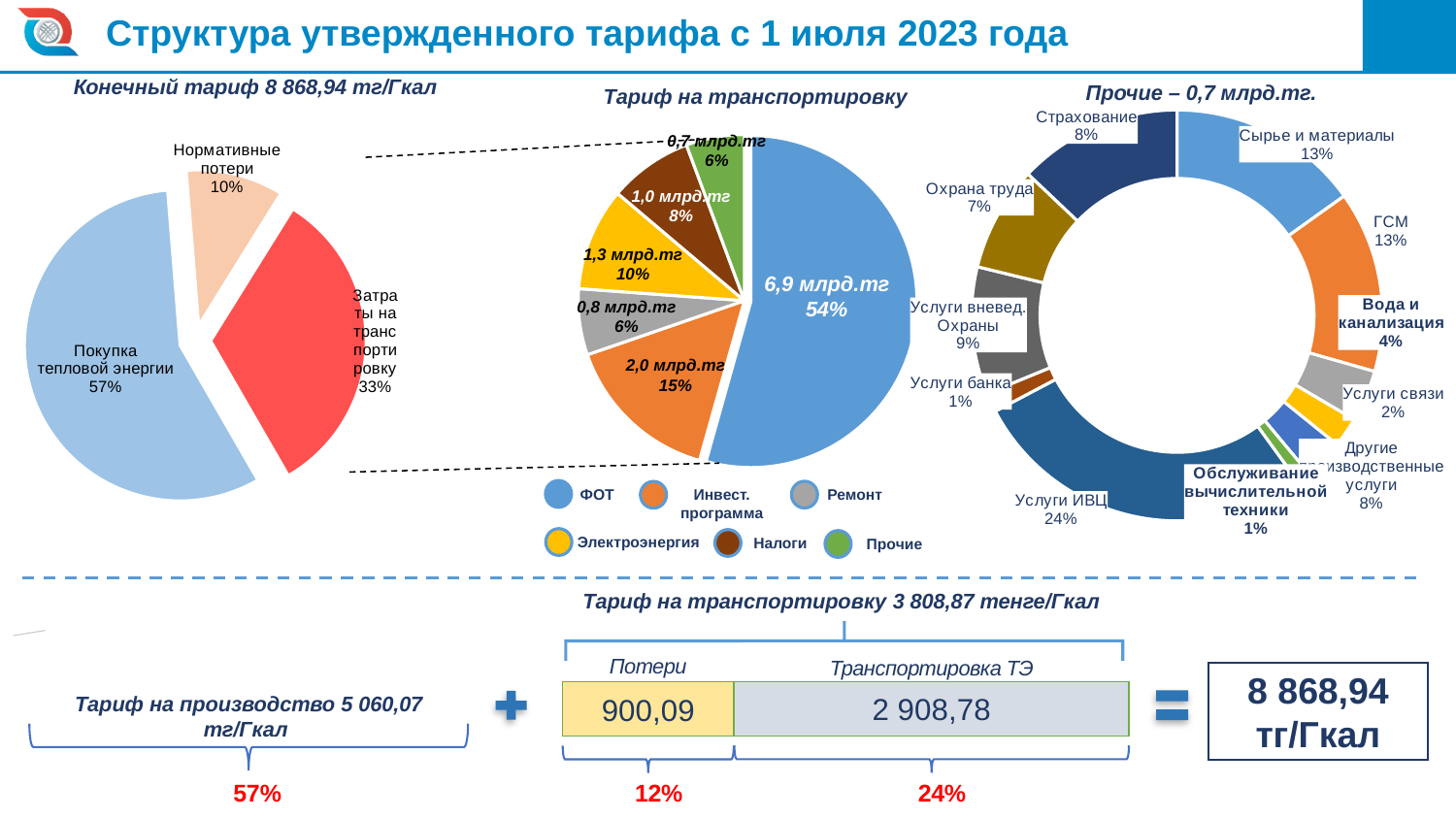
In the middle pie chart 'Тариф на транспортировку', how many entries does the legend list? 6 In the right doughnut chart 'Прочие – 0,7 млрд.тг', how many categories are shown? 11 In the middle pie chart 'Тариф на транспортировку', what is the value for ФОТ? 6,9 млрд.тг In the middle pie chart 'Тариф на транспортировку', which category has the largest share? ФОТ In the middle pie chart 'Тариф на транспортировку', what share does 'Инвест. программа' have? 15% In the right doughnut chart 'Прочие – 0,7 млрд.тг', what share is 'Услуги ИВЦ'? 24% In the left pie chart 'Конечный тариф 8 868,94 тг/Гкал', which category has the smallest share? Нормативные потери In the left pie chart 'Конечный тариф 8 868,94 тг/Гкал', how many slices are there? 3 In the left pie chart 'Конечный тариф 8 868,94 тг/Гкал', what share is 'Покупка тепловой энергии'? 57% What kind of chart is the chart titled 'Прочие – 0,7 млрд.тг' on the right? Doughnut chart In the right doughnut chart 'Прочие – 0,7 млрд.тг', which is larger: 'Охрана труда' or 'Вода и канализация'? Охрана труда In the middle pie chart 'Тариф на транспортировку', what is the difference in percentage points between ФОТ and Электроэнергия? 44